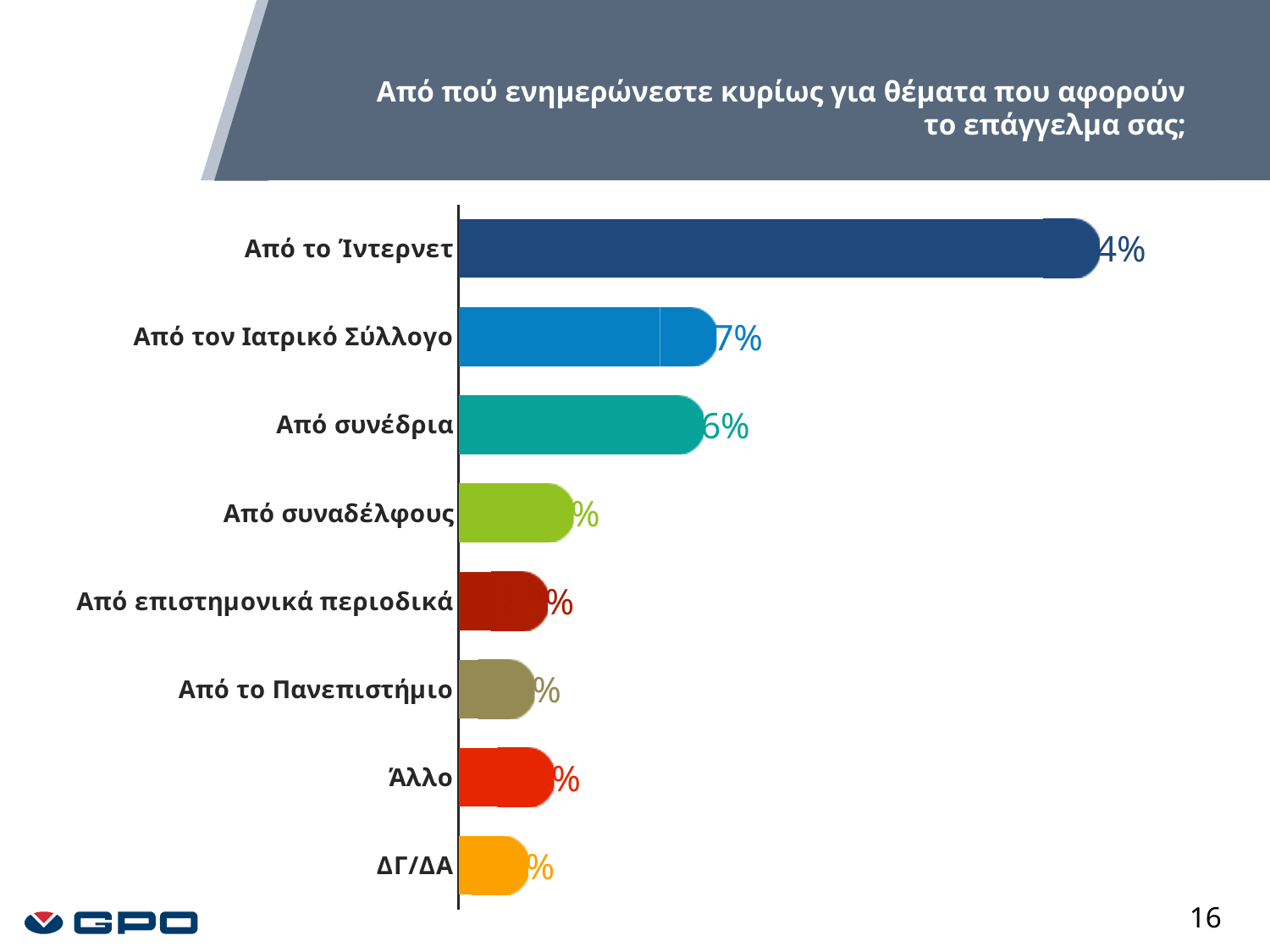
Which is larger: the value for Από συνέδρια or the value for Από συναδέλφους? Από συνέδρια Which category has the highest value in the chart? Από το Ίντερνετ Which is larger: the value for Από το Ίντερνετ or the value for Από τον Ιατρικό Σύλλογο? Από το Ίντερνετ Which category is listed at the top of the chart? Από το Ίντερνετ How many categories are shown in the chart? 8 What is the title of the chart on the slide? Από πού ενημερώνεστε κυρίως για θέματα που αφορούν το επάγγελμα σας; Which is larger: the value for Από τον Ιατρικό Σύλλογο or the value for ΔΓ/ΔΑ? Από τον Ιατρικό Σύλλογο What kind of chart is shown on the slide? Bar chart